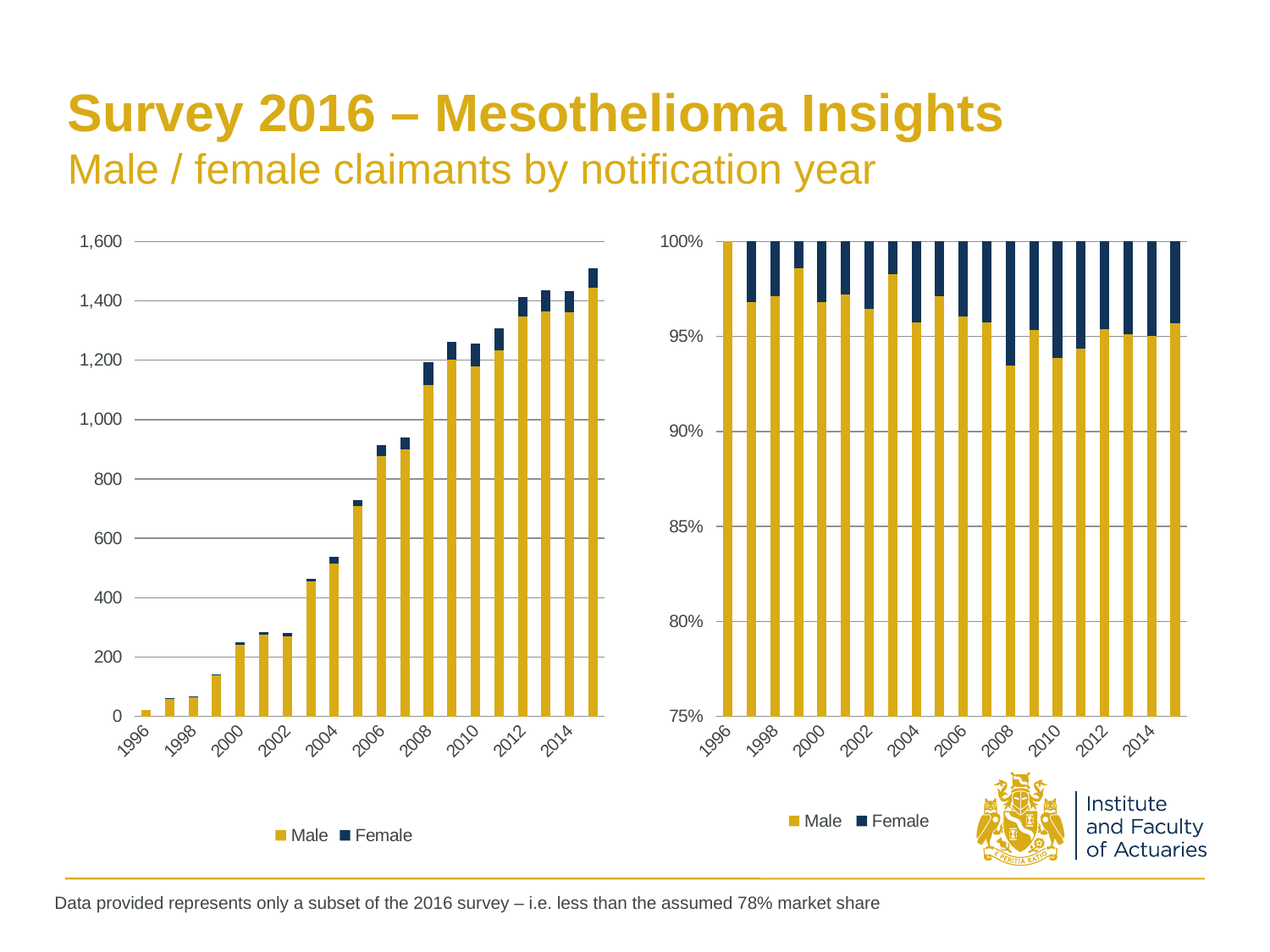
In the left chart, which year has the highest total number of claimants? 2015 In the left chart, is the total number of claimants for 2004 greater or less than 400? greater In the right chart, which year has the lowest male share of claimants? 2008 In the left chart, do the total claimant numbers generally rise or fall from 1996 to 2015? rise What kind of chart is the left chart on the slide? bar chart In the right chart, is the male share of claimants for 2008 greater or less than 95%? less In the left chart, is the total number of claimants for 2008 greater or less than 1,000? greater In the left chart, which year has the lowest total number of claimants? 1996 What are the two legend entries shown for the right chart? Male and Female How many years (bars) are plotted in the left chart? 20 How many series does the legend of the left chart list? 2 In the left chart, which year has the larger total number of claimants, 2005 or 2007? 2007